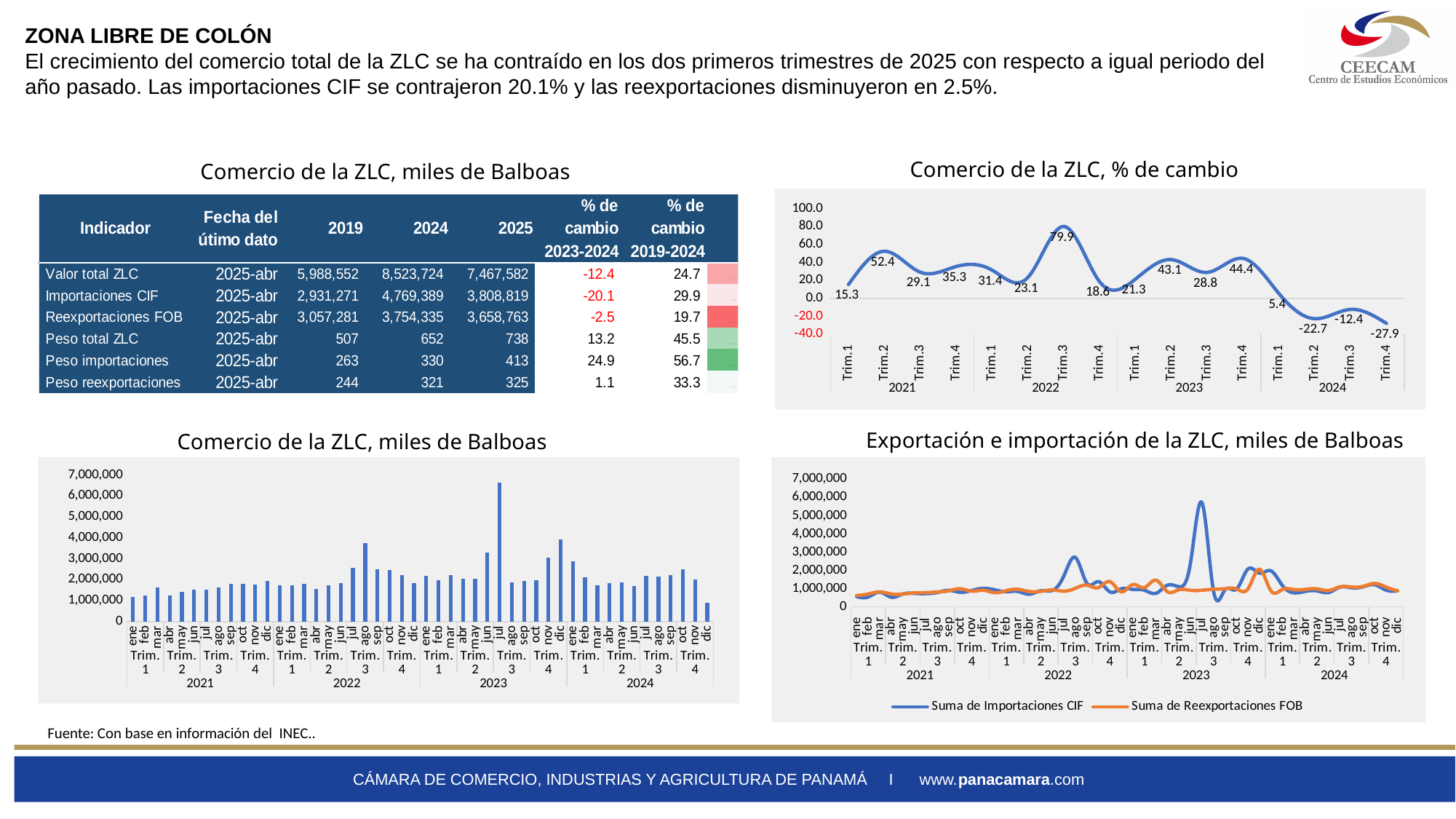
In the chart 'Comercio de la ZLC, % de cambio', what is the difference between the values for Trim.2 2021 and Trim.1 2021? 37.1 In the bottom-left chart 'Comercio de la ZLC, miles de Balboas', is the value for jul 2023 greater or less than 6,000,000? greater What kind of chart is the bottom-left chart 'Comercio de la ZLC, miles de Balboas'? bar chart In the chart 'Comercio de la ZLC, % de cambio', which quarter has the highest value? Trim.3 2022 In the chart 'Comercio de la ZLC, % de cambio', what is the value for Trim.3 of 2022? 79.9 In the chart 'Comercio de la ZLC, % de cambio', which quarter has the lowest value? Trim.4 2024 How many series does the legend of the chart 'Exportación e importación de la ZLC, miles de Balboas' list? 2 In the chart 'Comercio de la ZLC, % de cambio', how many quarterly data points are plotted? 16 In the chart 'Comercio de la ZLC, % de cambio', what is the value for Trim.4 of 2024? -27.9 In the chart 'Comercio de la ZLC, % de cambio', which is larger: the value for Trim.2 2023 or Trim.3 2023? Trim.2 2023 In the chart 'Exportación e importación de la ZLC, miles de Balboas', which series is larger in jul 2023: Suma de Importaciones CIF or Suma de Reexportaciones FOB? Suma de Importaciones CIF